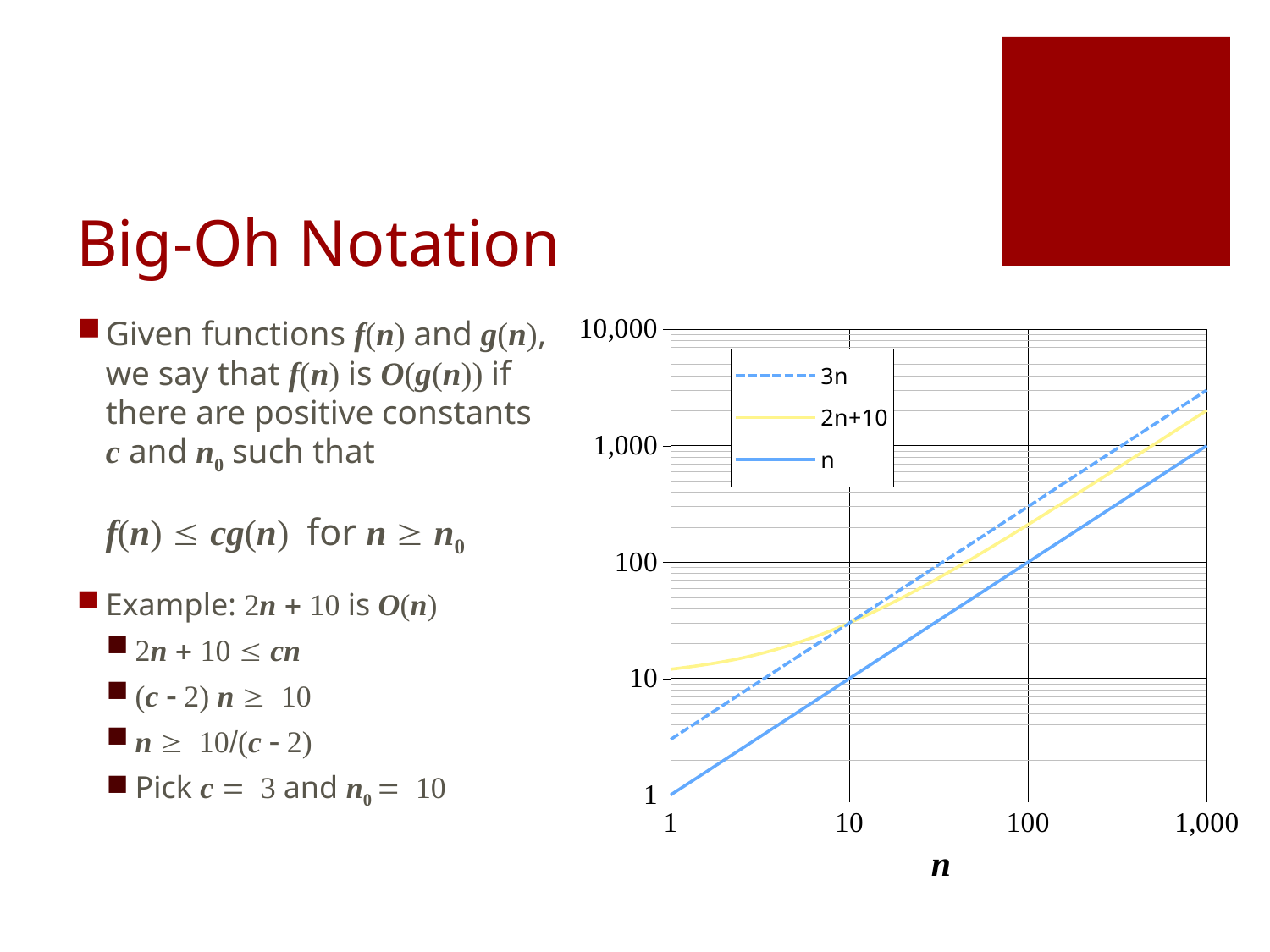
How many series does the chart's legend list? 3 What is the value of the n series at n = 1,000? 1,000 Is the value of the 2n+10 series at n = 1 greater or less than 10? greater Which series has the highest value at n = 1,000? 3n Which series has the lowest value at n = 100? n Do the values of the n series rise or fall as n increases along the x axis? rise What is the value of the n series at n = 100? 100 What is the label on the chart's x axis? n At n = 1,000, which is larger: the value of 3n or the value of n? 3n What kind of chart is shown on the slide? line chart Which series does the legend show with a dashed line? 3n Is the value of the 3n series at n = 1,000 greater or less than 1,000? greater